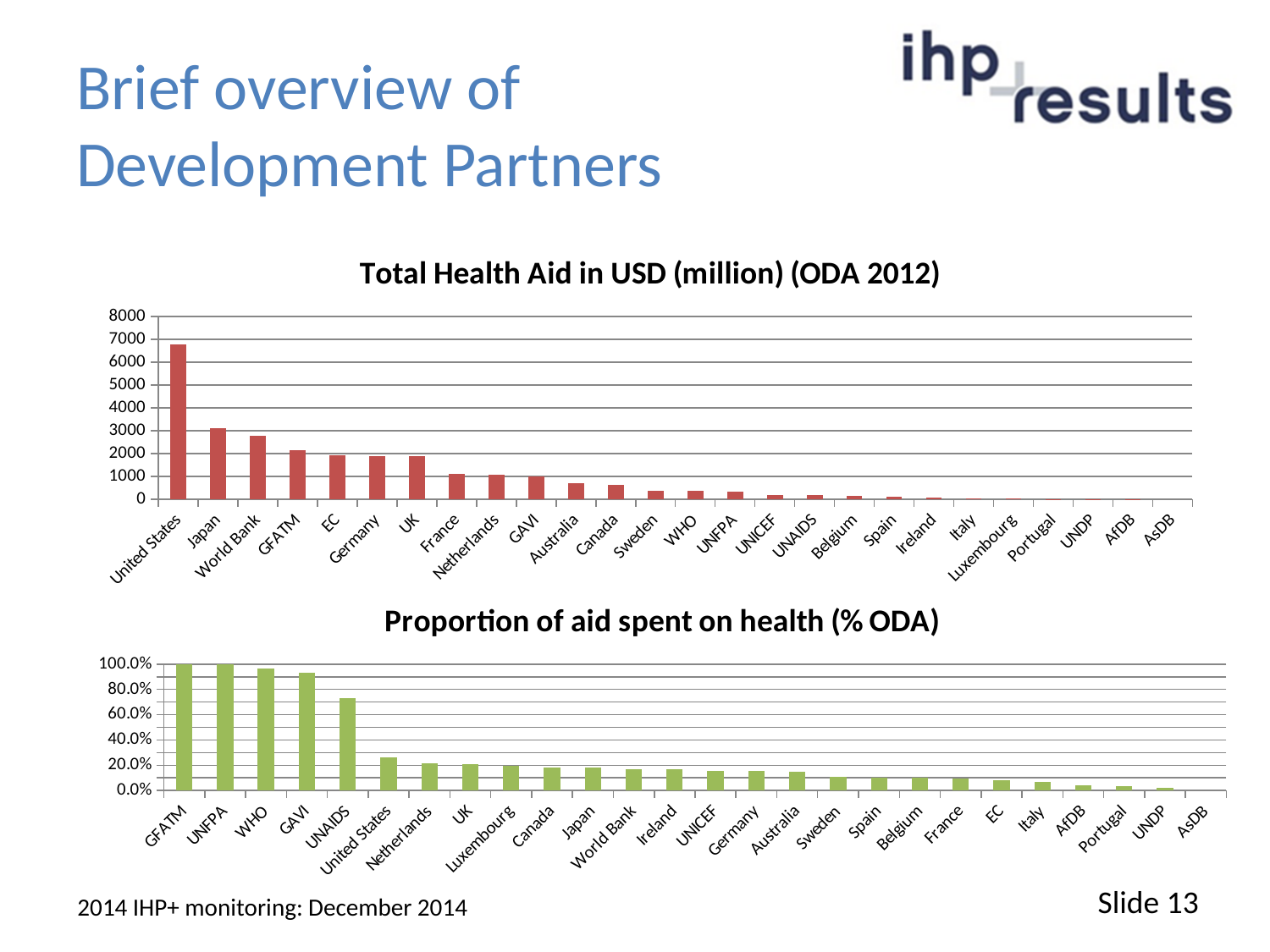
In the 'Total Health Aid in USD (million) (ODA 2012)' chart, is the value for Japan greater or less than 4000? less In the 'Total Health Aid in USD (million) (ODA 2012)' chart, is the value for United States greater or less than 6000? greater In the 'Total Health Aid in USD (million) (ODA 2012)' chart, which development partner has the highest value? United States What colour are the bars in the 'Proportion of aid spent on health (% ODA)' chart? green What kind of chart is the 'Proportion of aid spent on health (% ODA)' chart? bar chart In the 'Proportion of aid spent on health (% ODA)' chart, is the value for UNAIDS greater or less than 60.0%? greater How many development partners are shown in the 'Total Health Aid in USD (million) (ODA 2012)' chart? 26 In the 'Total Health Aid in USD (million) (ODA 2012)' chart, which is larger, the value for Japan or the value for World Bank? Japan In the 'Proportion of aid spent on health (% ODA)' chart, which is larger, the value for GAVI or the value for UNAIDS? GAVI In the 'Total Health Aid in USD (million) (ODA 2012)' chart, do the values rise or fall from left to right along the x axis? fall